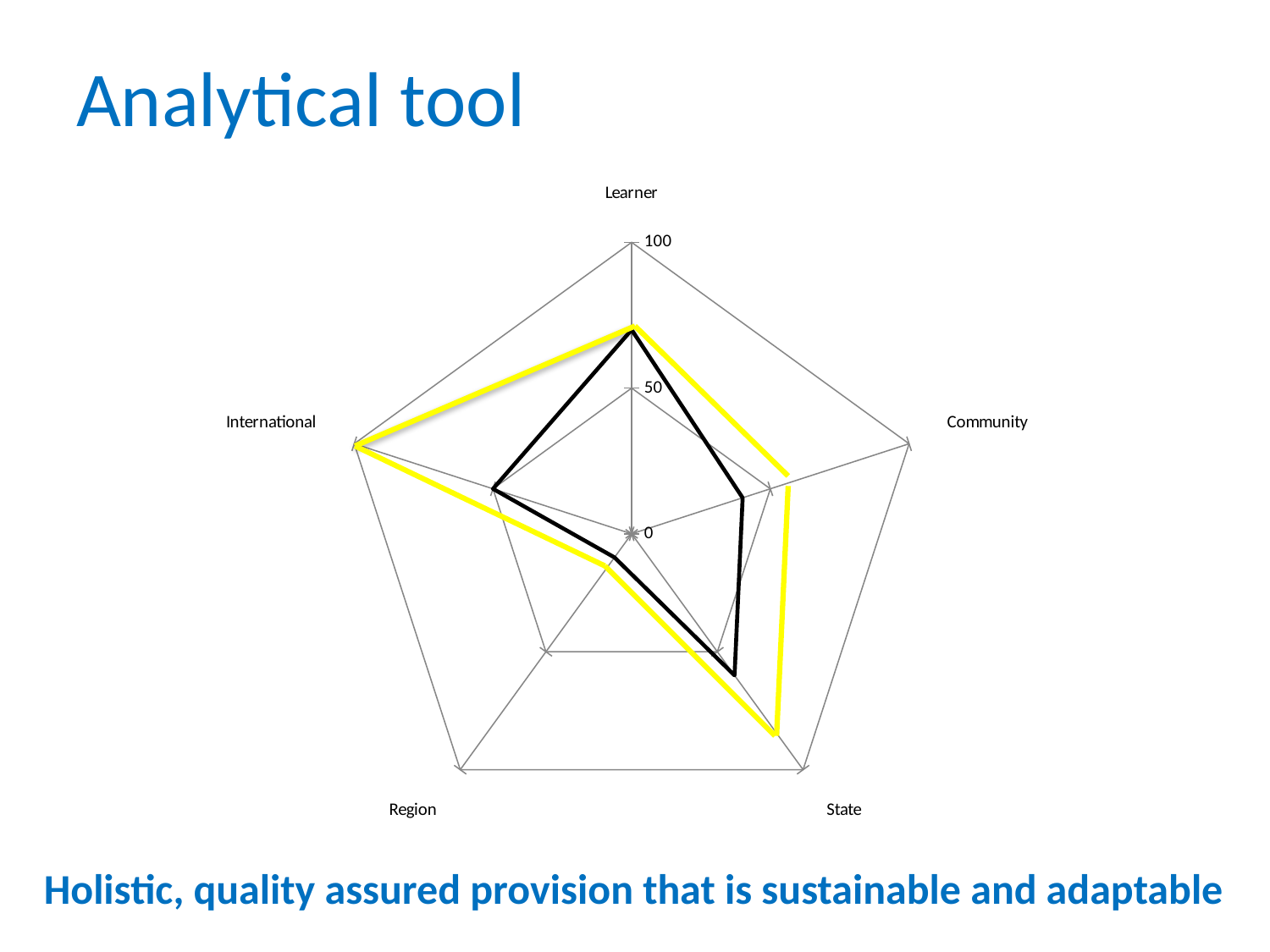
For International, which line has the larger value, the yellow line or the black line? Yellow line For State, which line has the larger value, the yellow line or the black line? Yellow line On which category does the yellow line reach its highest value? International What is the title of the slide containing the chart? Analytical tool Is the yellow line's value for International greater or less than 50? greater Is the yellow line's value for State greater or less than 50? greater Is the black line's value for Community greater or less than 50? less How many data series (lines) are plotted on the radar chart? 2 How many categories (axes) does the radar chart have? 5 On which category does the black line have its lowest value? Region What kind of chart is shown on the slide? Radar chart